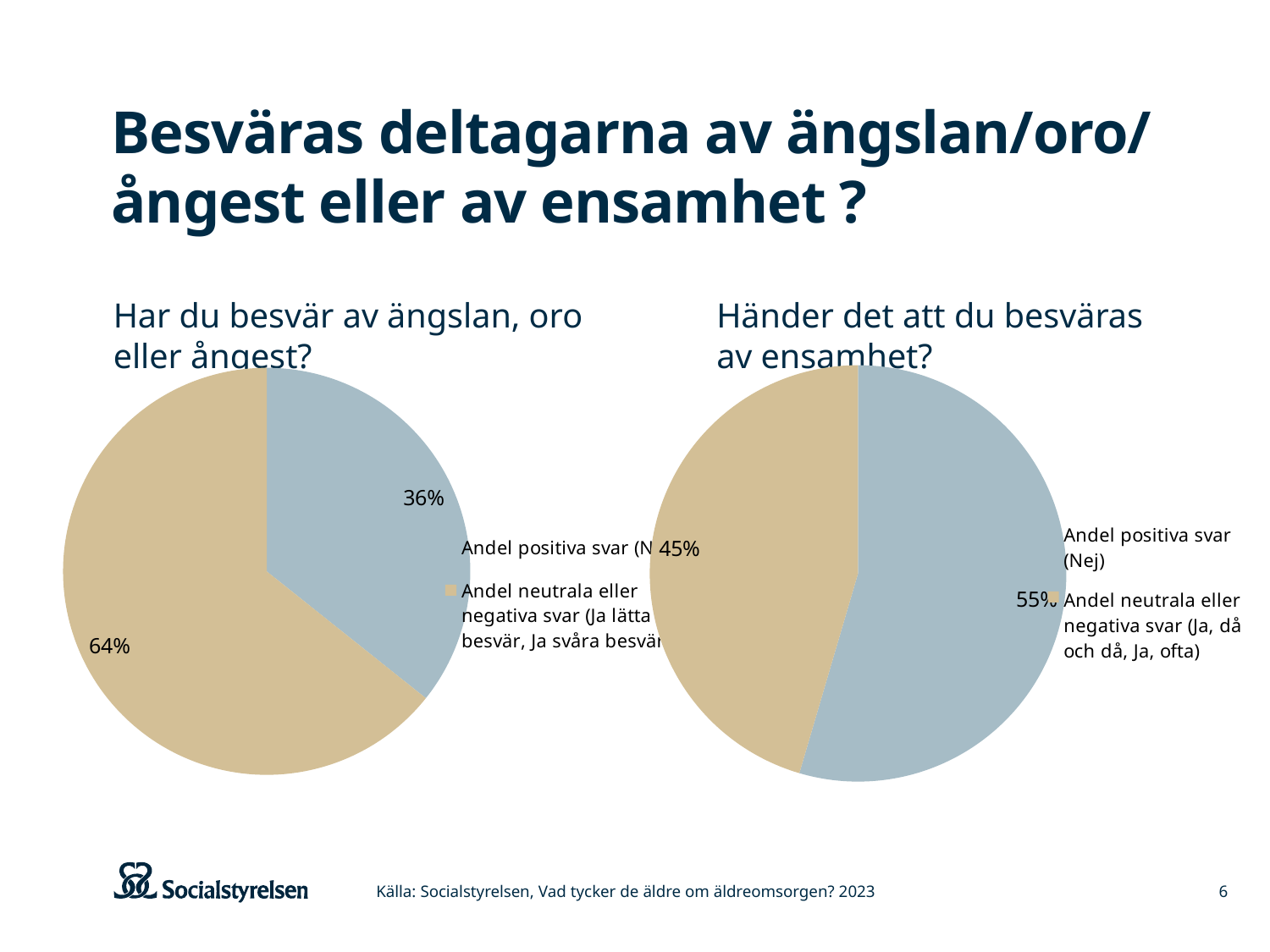
How many slices does the chart 'Händer det att du besväras av ensamhet?' have? 2 Is the positive share larger in the chart 'Har du besvär av ängslan, oro eller ångest?' or in the chart 'Händer det att du besväras av ensamhet?'? Händer det att du besväras av ensamhet? In the chart 'Händer det att du besväras av ensamhet?', what is the difference between the positive share and the neutral/negative share? 10 percentage points In the chart 'Har du besvär av ängslan, oro eller ångest?', what share of answers are positive (Nej)? 36% In the chart 'Har du besvär av ängslan, oro eller ångest?', what is the difference between the neutral/negative share and the positive share? 28 percentage points What type of chart is used on the left of the slide? Pie chart In the chart 'Har du besvär av ängslan, oro eller ångest?', what share of answers are neutral or negative? 64% In the chart 'Händer det att du besväras av ensamhet?', which colour represents the positive answers (Nej)? Blue In the chart 'Händer det att du besväras av ensamhet?', which category has the smallest slice? Andel neutrala eller negativa svar In the chart 'Händer det att du besväras av ensamhet?', what share of answers are positive (Nej)? 55% In the chart 'Händer det att du besväras av ensamhet?', what share of answers are neutral or negative (Ja, då och då, Ja, ofta)? 45% In the chart 'Har du besvär av ängslan, oro eller ångest?', which category has the largest slice? Andel neutrala eller negativa svar